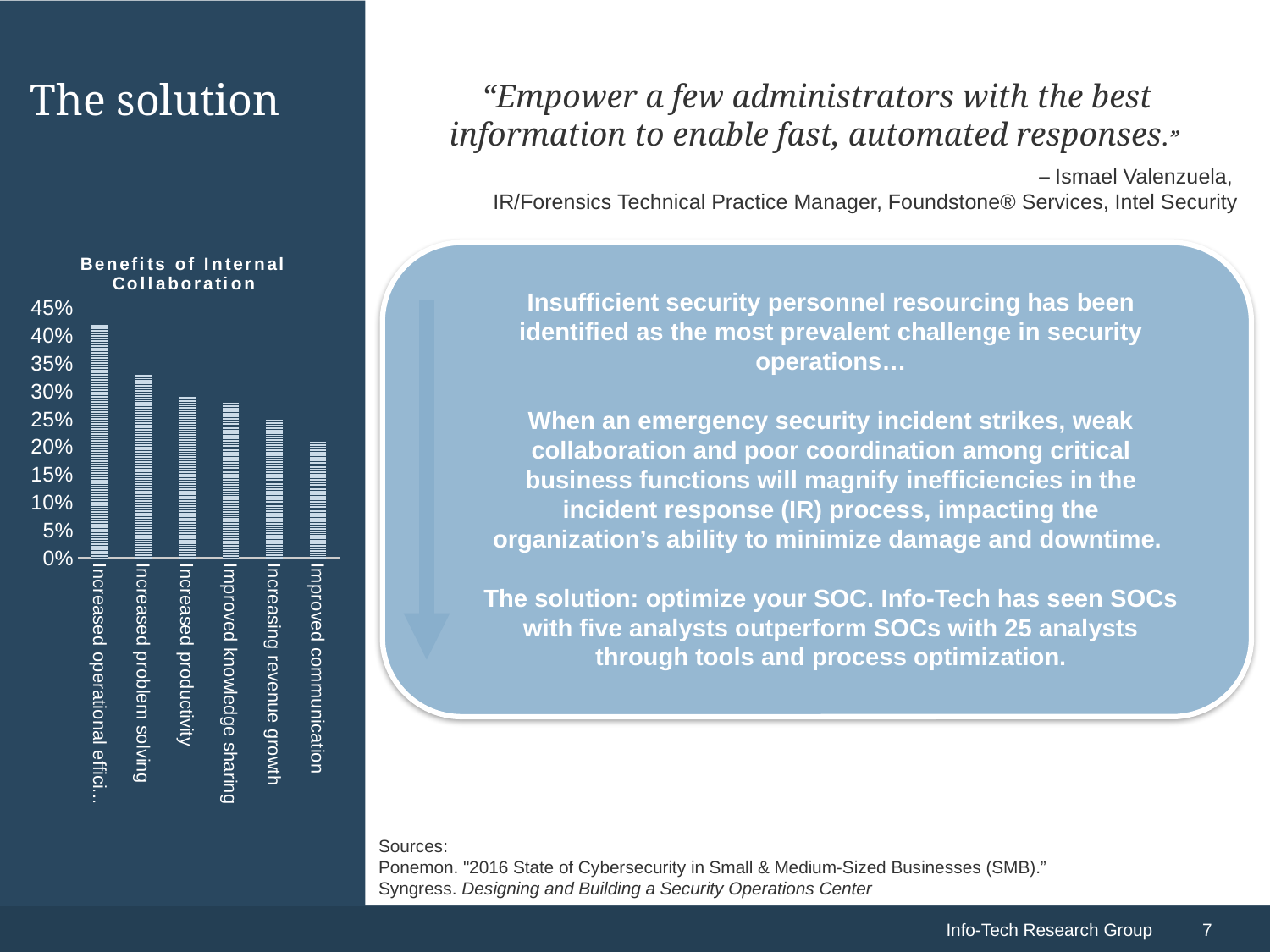
Is the value for Improved communication greater or less than 25%? less How many categories are plotted in the Benefits of Internal Collaboration chart? 6 What kind of chart is shown on the slide? Bar chart Which category has the highest value in the Benefits of Internal Collaboration chart? Increased operational effici... Is the value for Increased problem solving greater or less than 30%? greater Which is larger, the value for Increased productivity or the value for Increasing revenue growth? Increased productivity What is the title of the chart on the slide? Benefits of Internal Collaboration Is the value for Increased operational effici... greater or less than 35%? greater Which category has the lowest value in the Benefits of Internal Collaboration chart? Improved communication Do the values in the Benefits of Internal Collaboration chart rise or fall from left to right? Fall Which is larger, the value for Increased problem solving or the value for Improved communication? Increased problem solving